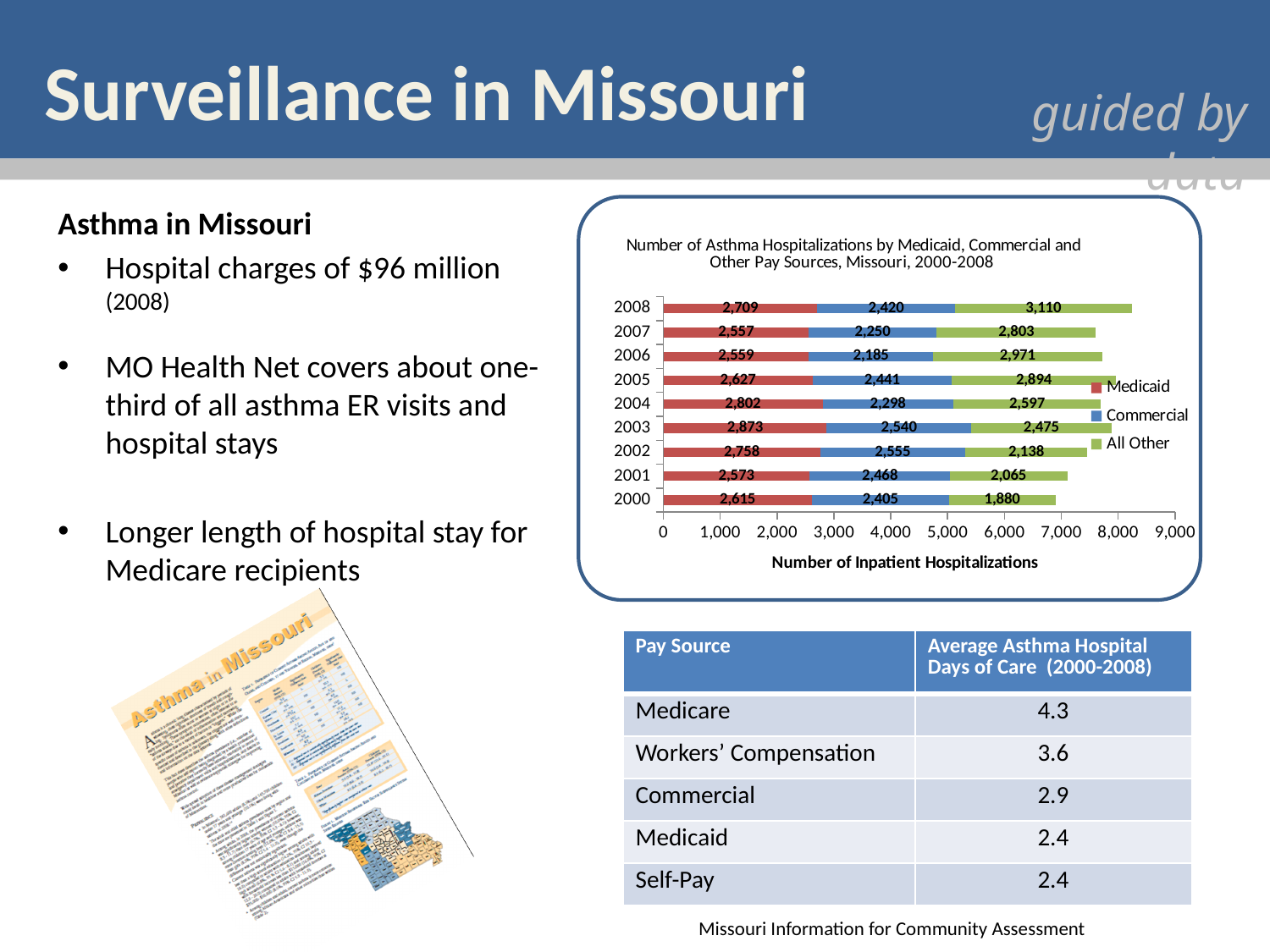
How many series does the chart legend list? 3 What is the title of the x axis on the chart? Number of Inpatient Hospitalizations Which is larger, the Medicaid value for 2003 or the Medicaid value for 2004? 2003 What is the difference between the All Other values for 2008 and 2000? 1,230 Which year has the highest All Other value? 2008 What is the total number of asthma hospitalizations across all three pay sources in 2008? 8,239 What is the number of Commercial asthma hospitalizations in 2003? 2,540 Which year has the lowest Commercial value? 2006 What type of chart is shown on the slide? Stacked bar chart What is the All Other value for 2000? 1,880 What is the number of Medicaid asthma hospitalizations in 2008? 2,709 How many years are shown on the chart? 9